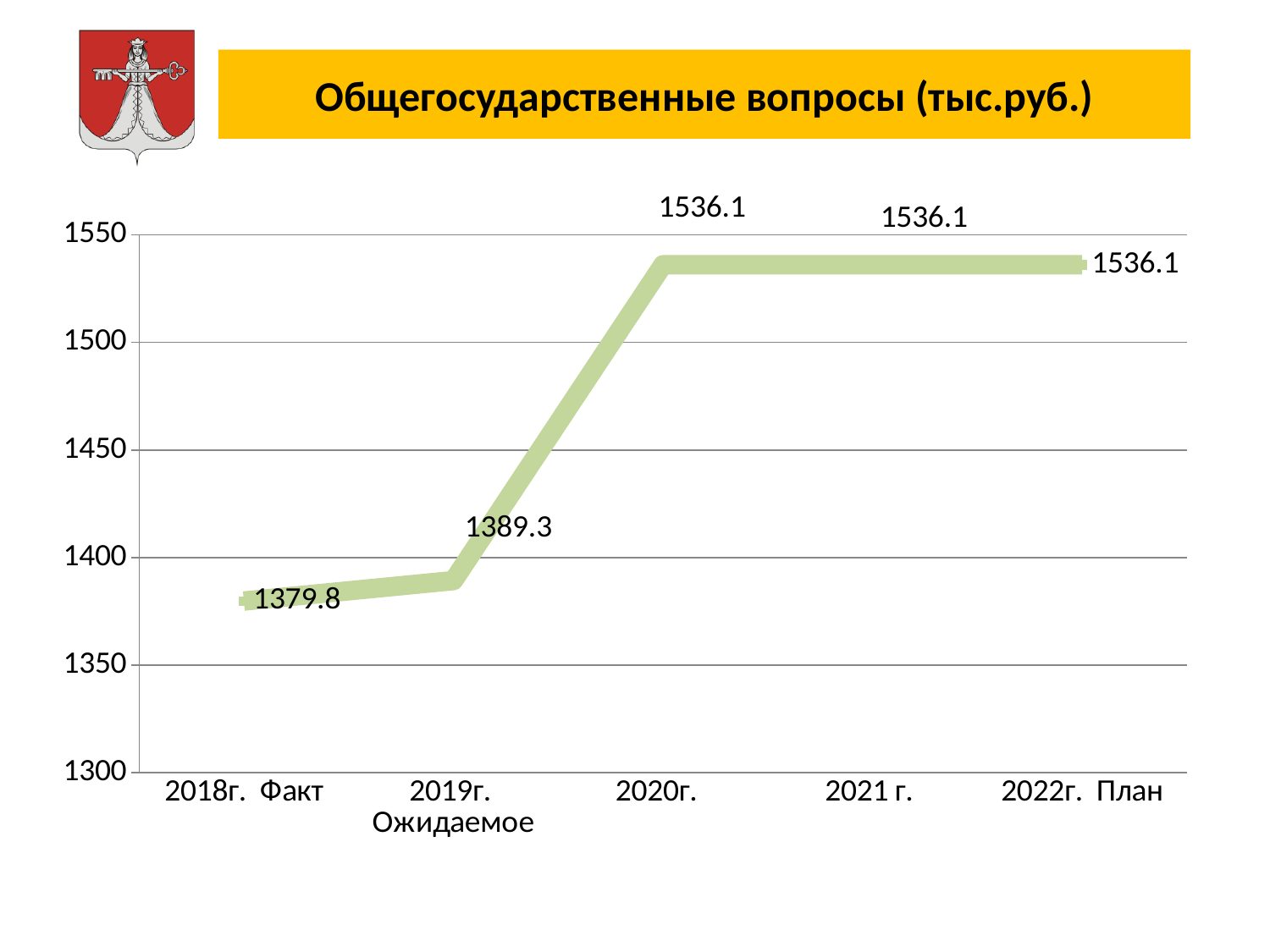
What is the value for 2022г. План? 1536.1 How many categories are shown on the x axis? 5 What is the difference between the values for 2020г. and 2019г. Ожидаемое? 146.8 Which category has the lowest value? 2018г. Факт What kind of chart is shown on the slide? line chart What is the value for 2020г.? 1536.1 Which is larger, the value for 2019г. Ожидаемое or the value for 2021 г.? 2021 г. What is the value for 2019г. Ожидаемое? 1389.3 What is the value for 2018г. Факт? 1379.8 What is the difference between the values for 2019г. Ожидаемое and 2018г. Факт? 9.5 Is the value for 2018г. Факт greater or less than 1400? less What is the title of the chart? Общегосударственные вопросы (тыс.руб.)